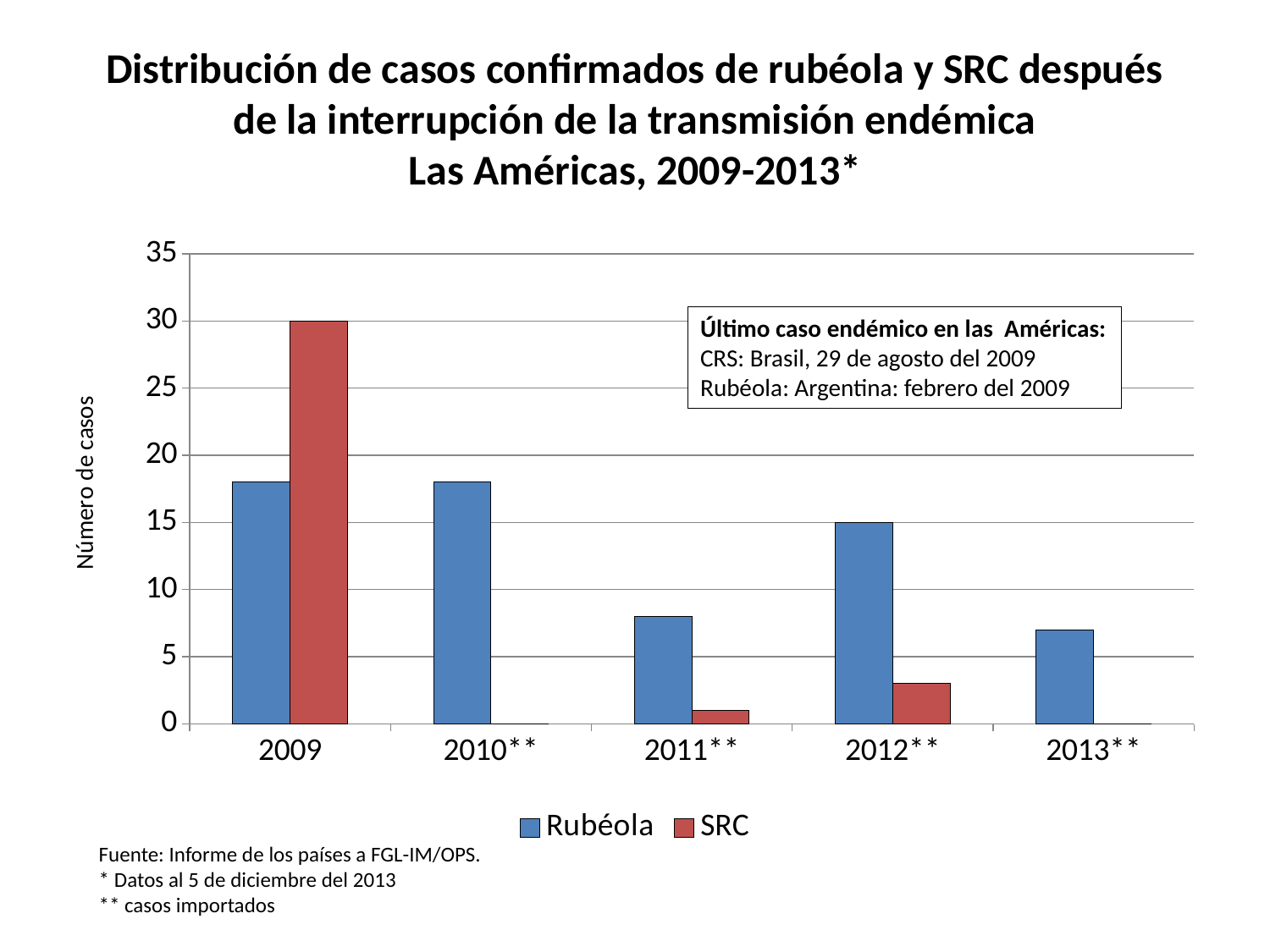
What is the label of the vertical axis? Número de casos What are the two series named in the legend? Rubéola and SRC What is the value for Rubéola in 2012**? 15 Which is larger for Rubéola, the value in 2011** or the value in 2012**? 2012** Is the value for Rubéola in 2013** greater or less than 10? less How many series does the legend list? 2 Is the value for Rubéola in 2009 greater or less than 15? greater What is the value for SRC in 2009? 30 How many year categories are shown on the x axis? 5 What type of chart is shown on the slide? bar chart Which is larger in 2009, the Rubéola value or the SRC value? SRC In which year is the SRC value highest? 2009